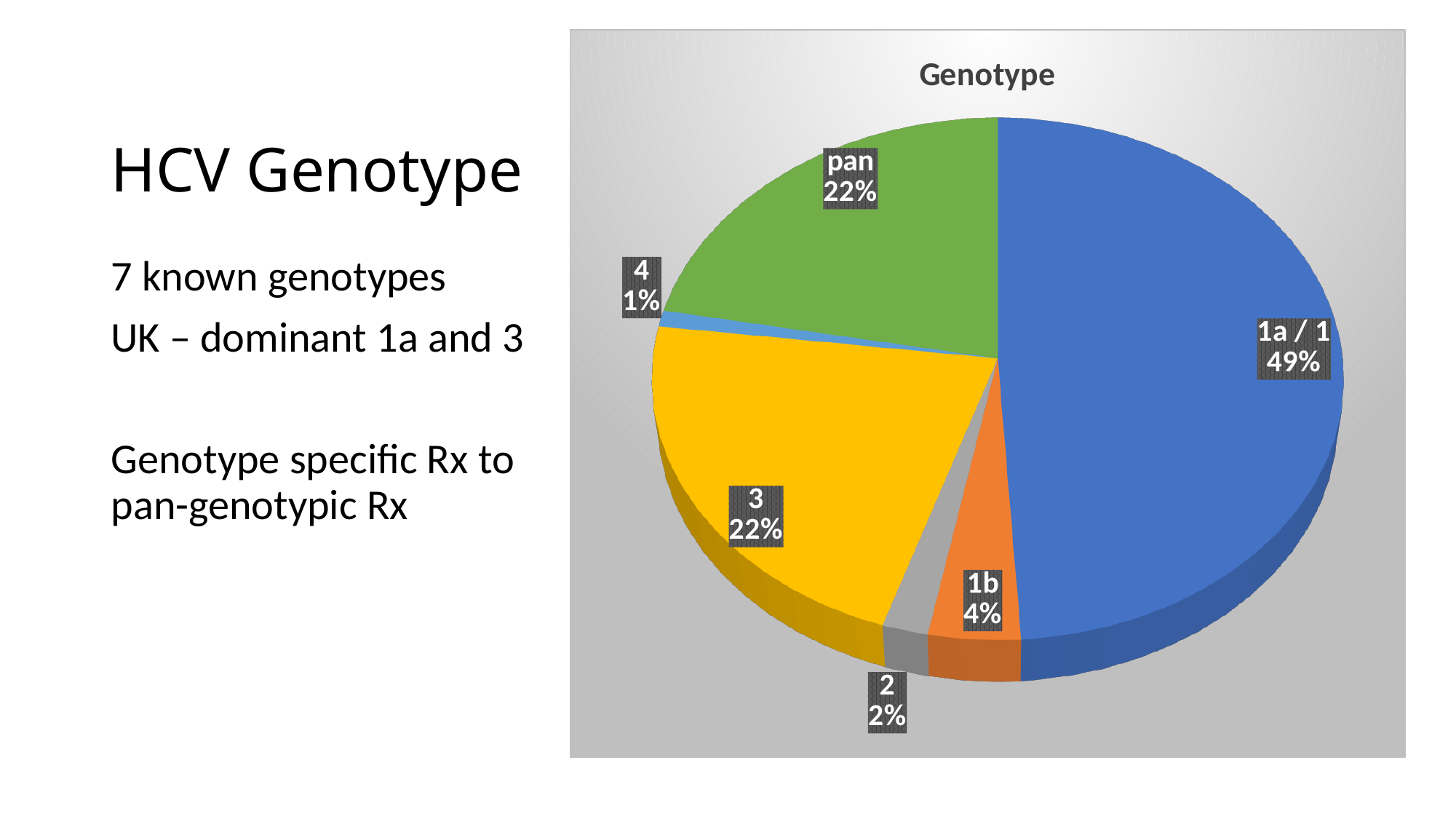
What share of the pie does the 1a / 1 slice represent? 49% What kind of chart is shown on the slide? Pie chart Which slice of the pie is the largest? 1a / 1 Which slice of the pie is the smallest? 4 What is the title of the chart? Genotype What share of the pie does the 3 slice represent? 22% What is the difference in percentage points between the 1a / 1 slice and the 3 slice? 27 What share of the pie does the 2 slice represent? 2% How many slices does the pie chart have? 6